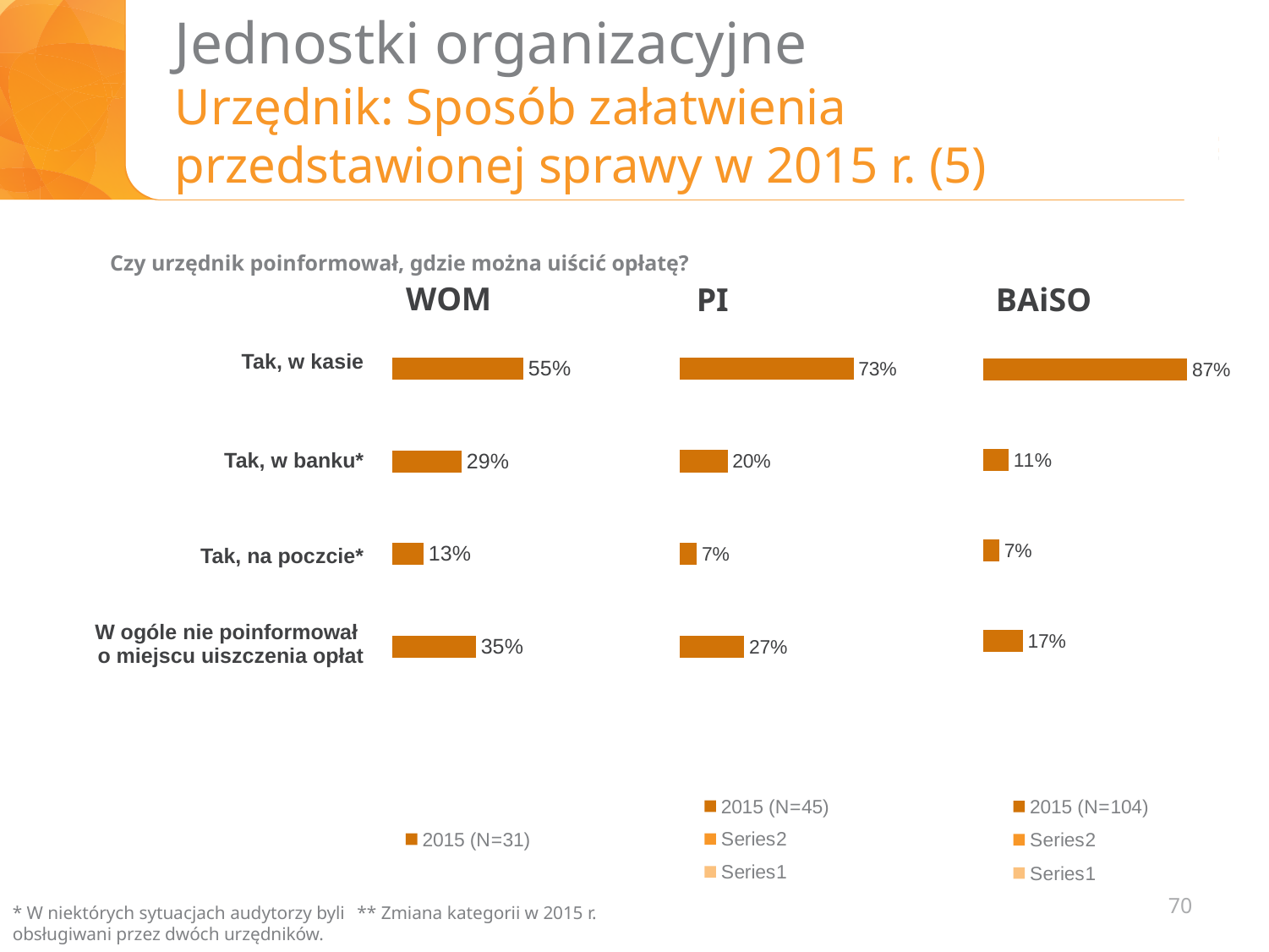
In the WOM chart, what is the difference between "Tak, w kasie" and "W ogóle nie poinformował o miejscu uiszczenia opłat"? 20 percentage points In the BAiSO chart, what is the value for "W ogóle nie poinformował o miejscu uiszczenia opłat"? 17% What kind of chart is the WOM chart? Bar chart In the WOM chart, what is the value for "Tak, w kasie"? 55% In the PI chart, which category has the lowest value? Tak, na poczcie* In the BAiSO chart, what is the difference between "Tak, w kasie" and "Tak, w banku*"? 76 percentage points In the PI chart, what is the value for "Tak, w banku*"? 20% In the WOM chart, which is larger: "Tak, w banku*" or "W ogóle nie poinformował o miejscu uiszczenia opłat"? W ogóle nie poinformował o miejscu uiszczenia opłat How many categories are shown in the PI chart? 4 How many entries does the legend of the PI chart list? 3 In the BAiSO chart, which category has the highest value? Tak, w kasie What is the legend entry shown under the WOM chart? 2015 (N=31)